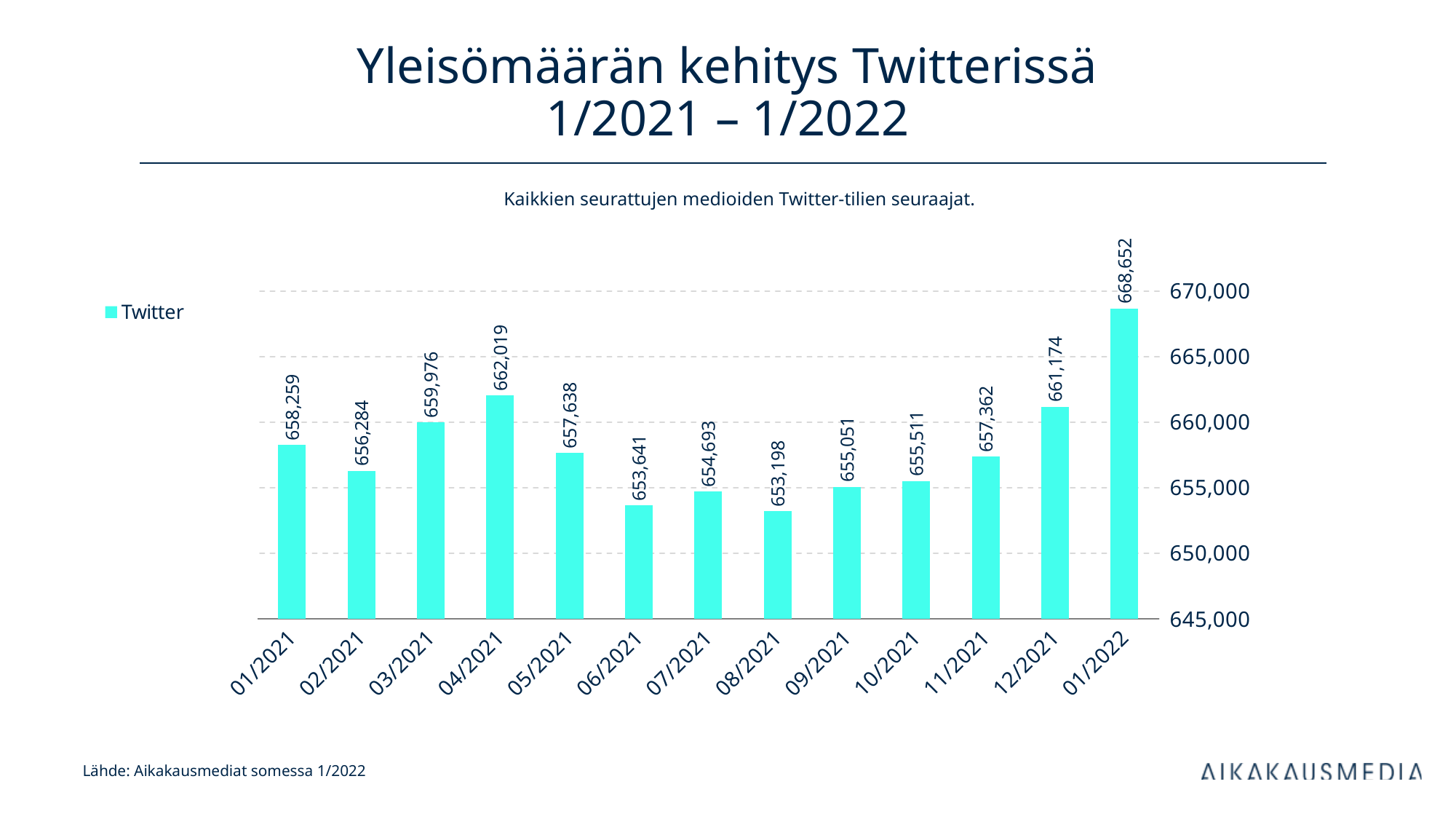
Which month has the lowest value? 08/2021 Which is larger, the value for 03/2021 or the value for 05/2021? 03/2021 What is the value for 04/2021? 662,019 What is the value for 01/2022? 668,652 How many series does the legend list? 1 What is the value for 08/2021? 653,198 What kind of chart is shown on the slide? bar chart How many months are shown on the x axis? 13 Is the value for 12/2021 greater or less than 660,000? greater What is the difference between the values for 01/2021 and 01/2022? 10,393 What is the difference between the values for 01/2022 and 12/2021? 7,478 Which month has the highest value? 01/2022